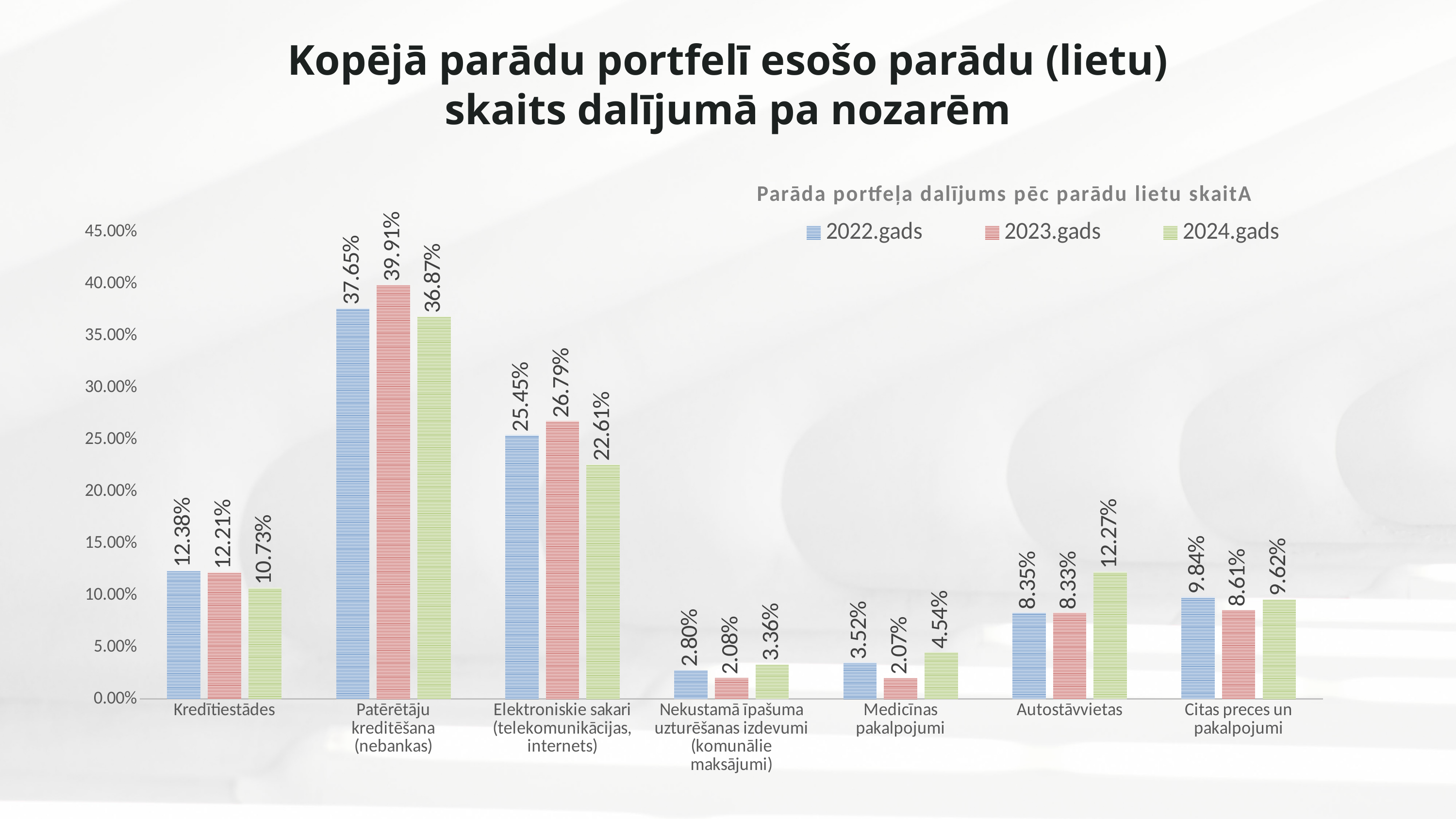
Which category has the highest value in the 2024.gads series? Patērētāju kreditēšana (nebankas) Is the 2022.gads value for Elektroniskie sakari (telekomunikācijas, internets) greater or less than 20.00%? greater Which category has the lowest value in the 2023.gads series? Medicīnas pakalpojumi What is the value for Patērētāju kreditēšana (nebankas) in the 2023.gads series? 39.91% How many series does the legend list? 3 What kind of chart is shown on the slide? bar chart What is the value for Medicīnas pakalpojumi in the 2022.gads series? 3.52% What is the title of the chart's legend? Parāda portfeļa dalījums pēc parādu lietu skaitA What is the value for Autostāvvietas in the 2024.gads series? 12.27% Which is larger for Kredītiestādes: the 2022.gads value or the 2024.gads value? 2022.gads What is the difference between the 2023.gads and 2024.gads values for Elektroniskie sakari (telekomunikācijas, internets)? 4.18% How many categories are shown on the x axis? 7